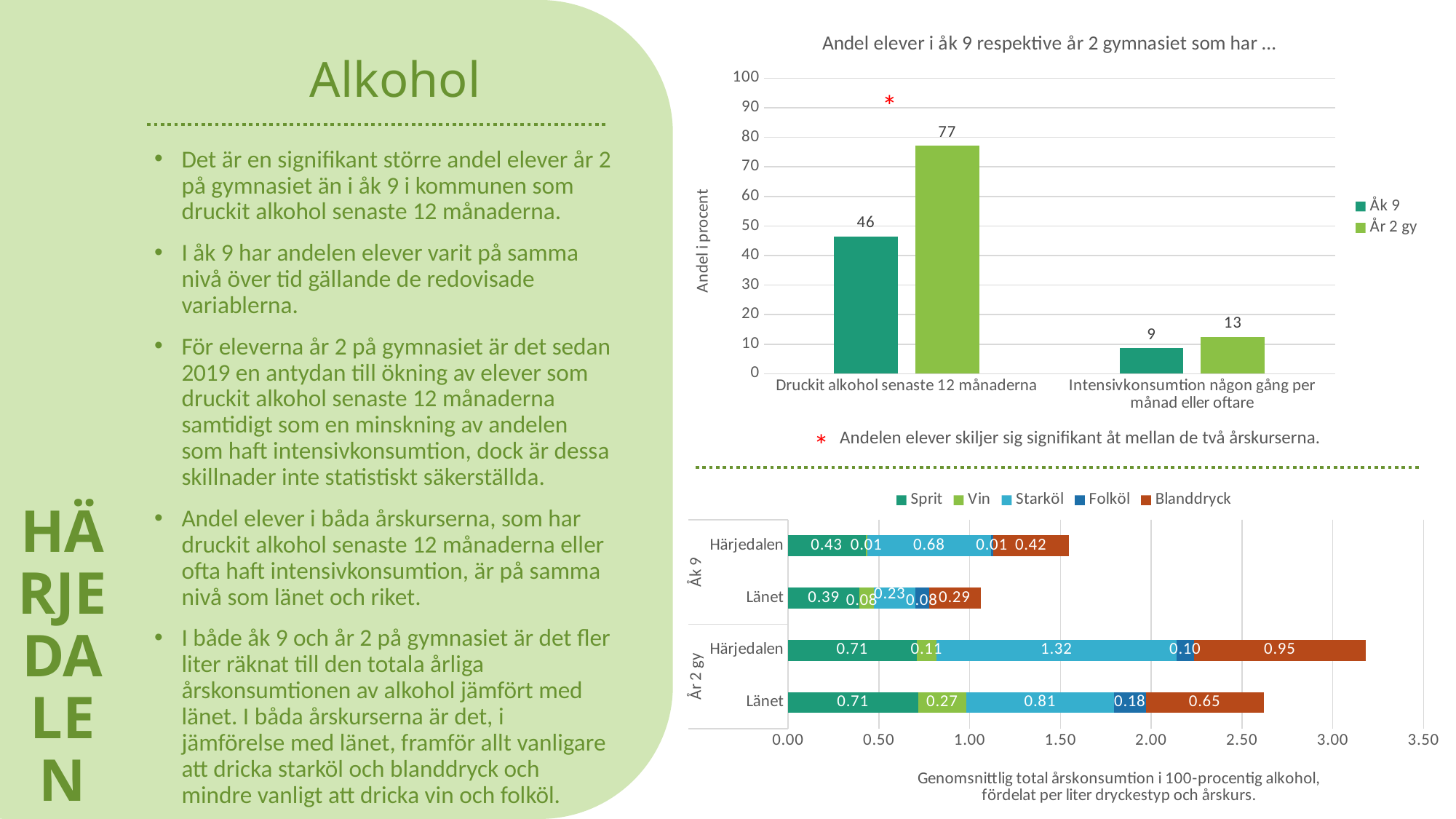
In the top chart, what is the value for År 2 gy for 'Intensivkonsumtion någon gång per månad eller oftare'? 13 In the bottom chart, what is the Starköl value for Härjedalen in År 2 gy? 1.32 In the top chart, what is the difference between År 2 gy and Åk 9 for 'Druckit alkohol senaste 12 månaderna'? 31 In the bottom chart, what is the total of the stacked bar for Länet in År 2 gy? 2.62 What kind of chart is the top chart? Bar chart In the bottom chart, which bar is the longest overall? Härjedalen, År 2 gy In the top chart, how many series does the legend list? 2 In the bottom chart, is the total for Härjedalen in År 2 gy greater or less than 3.00? greater In the top chart, which series has the higher value for 'Intensivkonsumtion någon gång per månad eller oftare'? År 2 gy In the bottom chart, what is the Blanddryck value for Länet in Åk 9? 0.29 In the top chart, what is the value for Åk 9 for 'Druckit alkohol senaste 12 månaderna'? 46 In the bottom chart, how many series does the legend list? 5